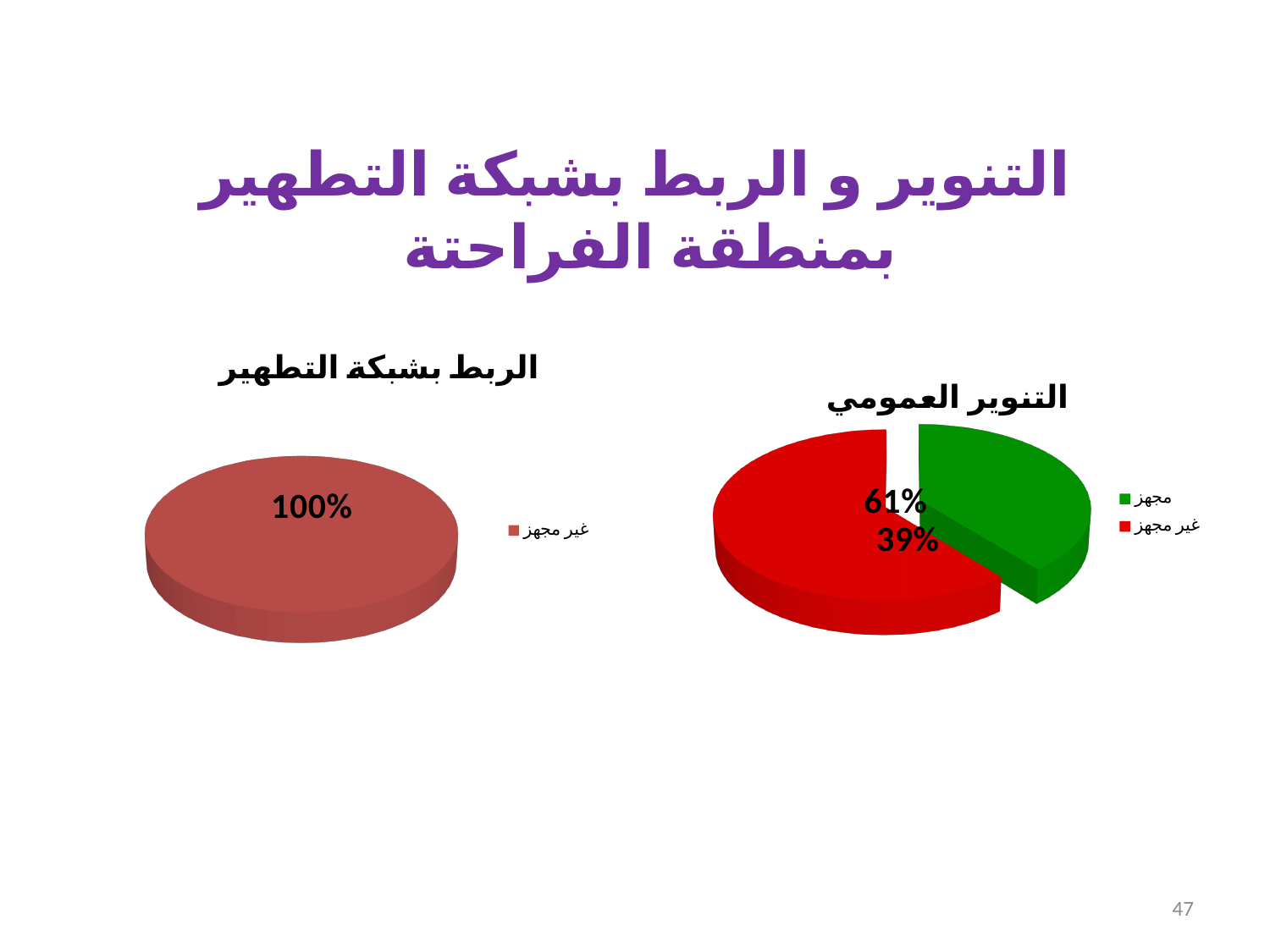
How many slices does the chart titled "التنوير العمومي" have? 2 In the chart titled "الربط بشبكة التطهير", what share does "غير مجهز" have? 100% In the chart titled "التنوير العمومي", what share does "مجهز" have? 39% How many slices does the chart titled "الربط بشبكة التطهير" have? 1 What kind of chart is the chart titled "التنوير العمومي"? pie chart How many entries does the legend of the chart titled "التنوير العمومي" list? 2 In the chart titled "التنوير العمومي", what colour is the "مجهز" slice? green In the chart titled "التنوير العمومي", what is the difference between the shares of "غير مجهز" and "مجهز"? 22% In the chart titled "التنوير العمومي", which slice is larger, "مجهز" or "غير مجهز"? غير مجهز What kind of chart is the chart titled "الربط بشبكة التطهير"? pie chart In the chart titled "التنوير العمومي", what share does "غير مجهز" have? 61% How many entries does the legend of the chart titled "الربط بشبكة التطهير" list? 1